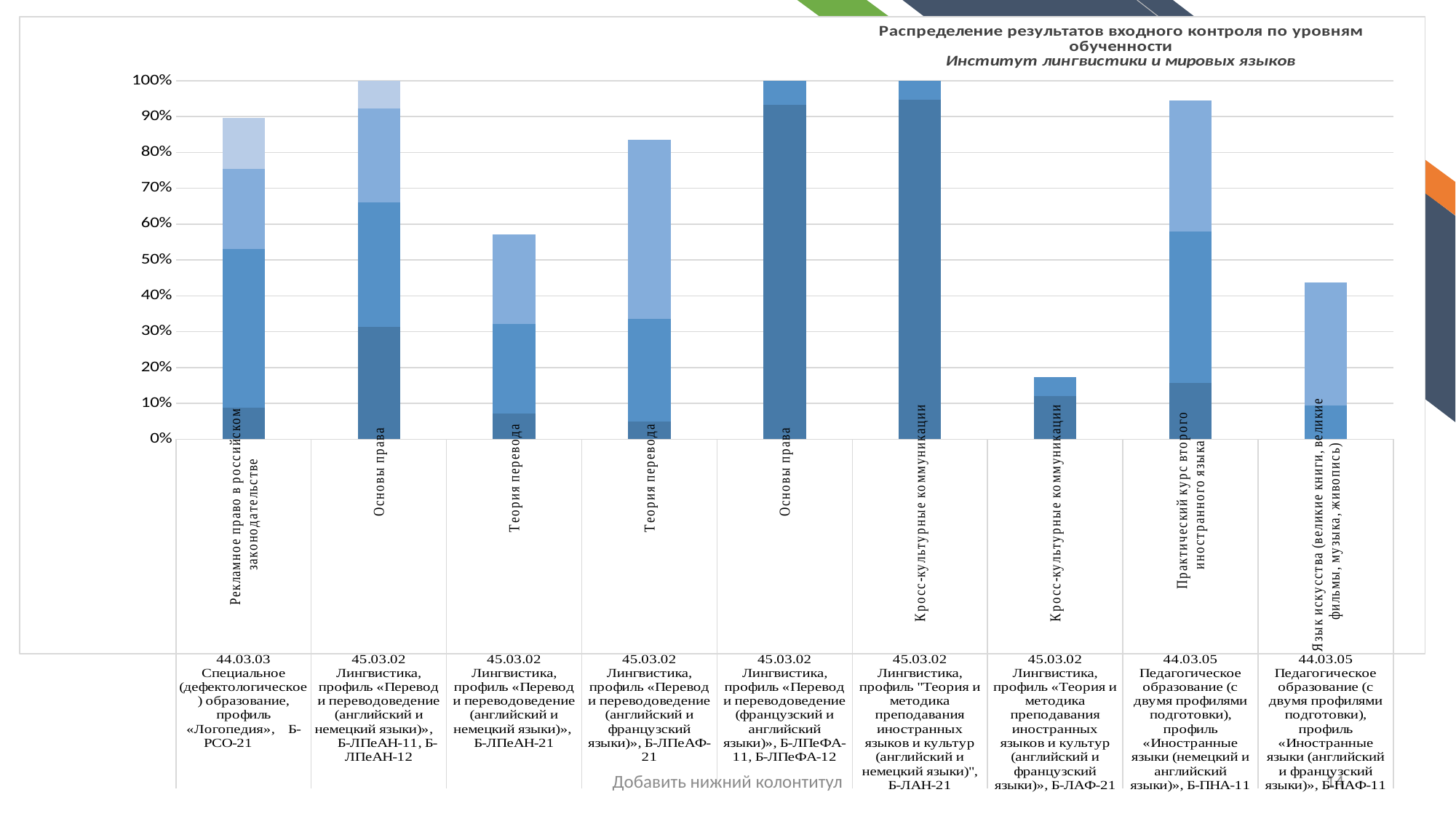
Which bar is taller in total: Теория перевода (Б-ЛПеАН-21) or Язык искусства (Б-ПАФ-11)? Теория перевода (Б-ЛПеАН-21) Is the total height of the bar for Теория перевода (Б-ЛПеАН-21) greater or less than 50%? greater Is the total height of the bar for Рекламное право в российском законодательстве (Б-РСО-21) greater or less than 80%? greater How many bars (disciplines/groups) are plotted on the chart? 9 Is the total height of the bar for Теория перевода (Б-ЛПеАФ-21) greater or less than 70%? greater Which bar has the lowest total height on the chart? Кросс-культурные коммуникации (Б-ЛАФ-21) What kind of chart is shown on the slide? Stacked bar chart What is the title of the chart? Распределение результатов входного контроля по уровням обученности Which institute is named in the chart's subtitle? Институт лингвистики и мировых языков